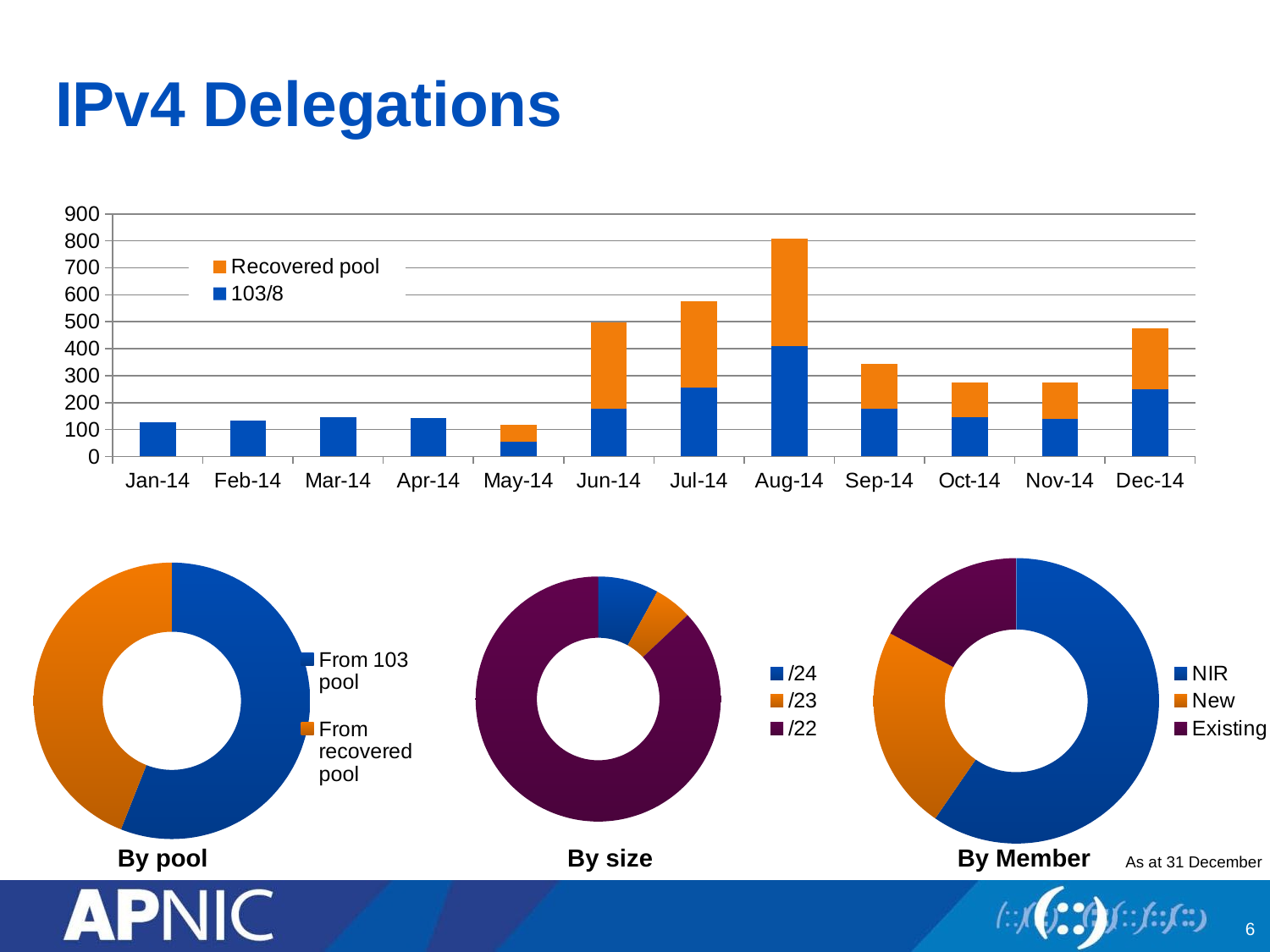
In the top bar chart, which month has the highest total bar? Aug-14 In the 'By Member' donut chart, which category has the largest share? NIR In the top bar chart, how many months are shown on the x axis? 12 In the top bar chart, which has the larger total bar, Jul-14 or Aug-14? Aug-14 In the top bar chart, is the total value for Aug-14 greater or less than 700? greater In the top bar chart, is the total value for Sep-14 greater or less than 400? less In the top bar chart, is the total value for Jan-14 greater or less than 200? less In the 'By size' donut chart, which category has the largest share? /22 In the top bar chart, do the total values rise or fall from Aug-14 to Oct-14? fall In the top bar chart, which series is shown in orange? Recovered pool What kind of chart is the top chart on the slide? bar chart In the top bar chart, how many series does the legend list? 2